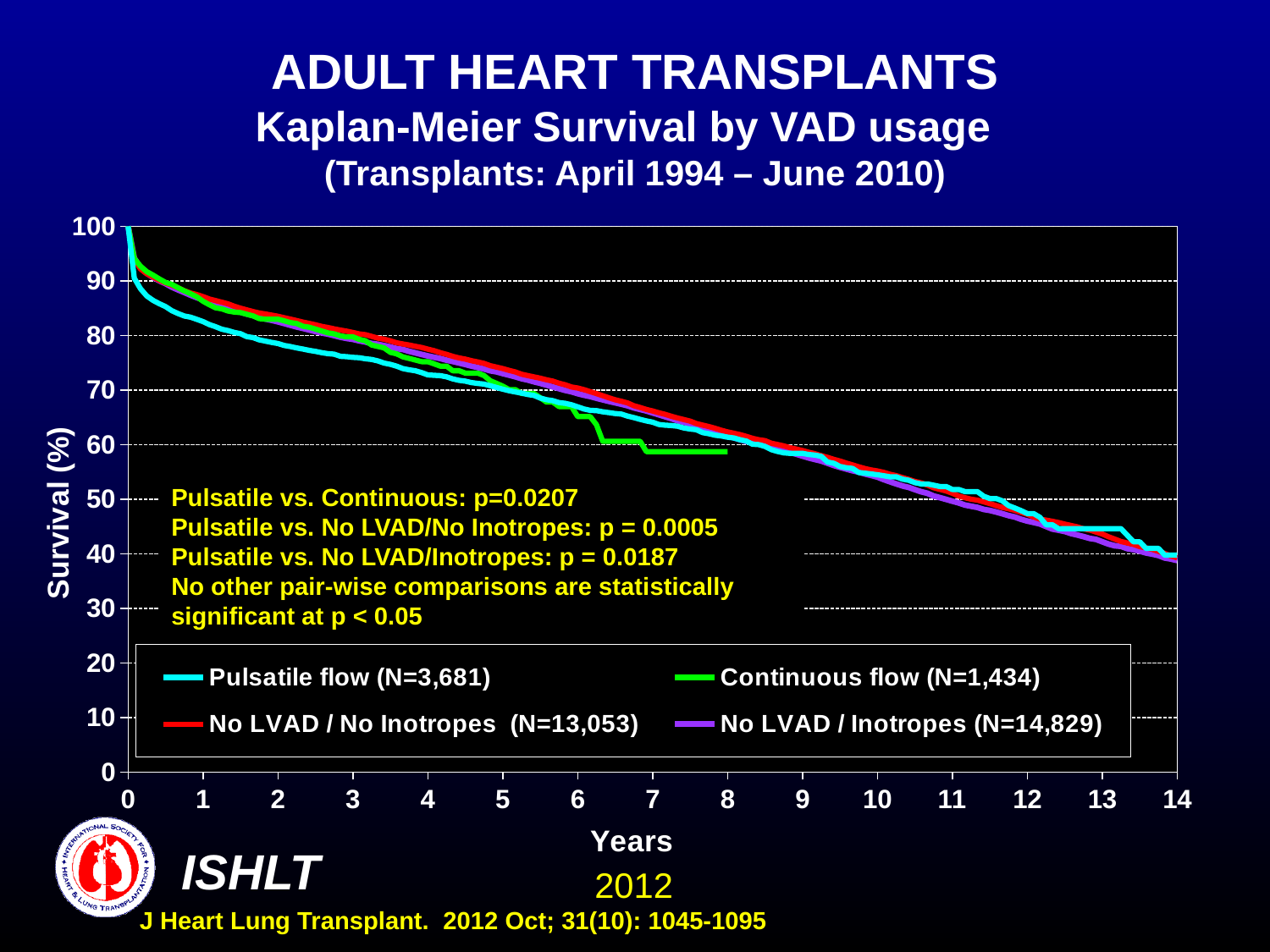
Is the survival value for Pulsatile flow at year 2 greater or less than 70? greater Do the survival curves rise or fall as the years increase? Fall At year 6.5, which series has higher survival: Continuous flow or No LVAD / No Inotropes? No LVAD / No Inotropes Is the survival value for Continuous flow at year 7 greater or less than 70? less According to the legend, what is the N for the Continuous flow series? N=1,434 How many series does the legend list? 4 Is the survival value for No LVAD / Inotropes at year 4 greater or less than 70? greater What is the label of the y axis? Survival (%) What kind of chart is shown on the slide? Line chart At year 1, which series has higher survival: Pulsatile flow or No LVAD / No Inotropes? No LVAD / No Inotropes